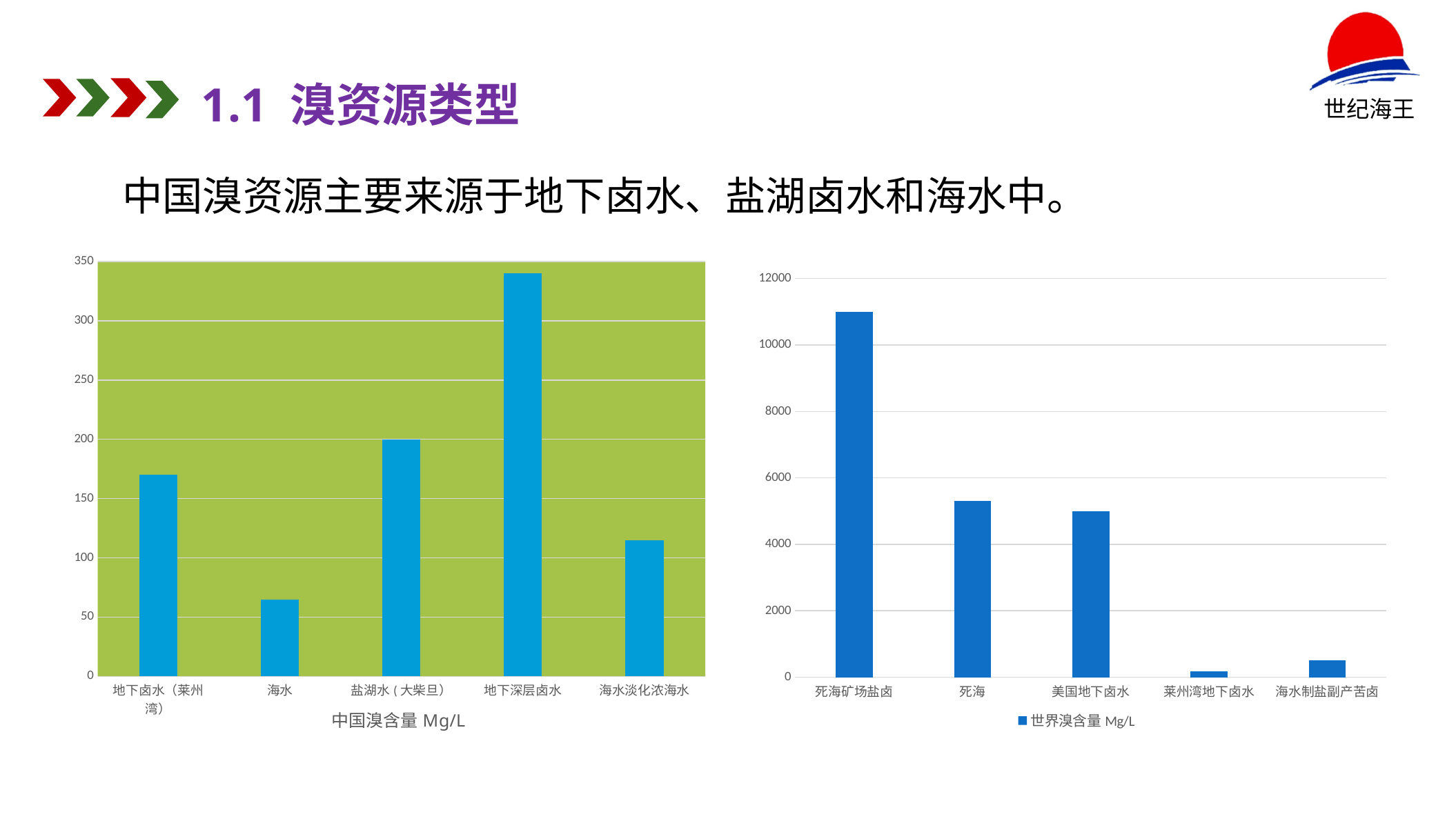
What is the legend entry shown below the right chart? 世界溴含量 Mg/L In the left chart (中国溴含量 Mg/L), which is larger, the value for 海水淡化浓海水 or the value for 盐湖水(大柴旦)? 盐湖水(大柴旦) In the left chart (中国溴含量 Mg/L), is the value for 海水 greater or less than 100? less How many categories are shown in the left chart (中国溴含量 Mg/L)? 5 In the right chart (世界溴含量 Mg/L), which category has the highest value? 死海矿场盐卤 How many series does the legend of the right chart (世界溴含量 Mg/L) list? 1 In the right chart (世界溴含量 Mg/L), is the value for 死海矿场盐卤 greater or less than 10000? greater In the left chart (中国溴含量 Mg/L), which category has the highest value? 地下深层卤水 In the left chart (中国溴含量 Mg/L), is the value for 地下卤水（莱州湾） greater or less than 150? greater What kind of chart is the left chart titled 中国溴含量 Mg/L? bar chart In the right chart (世界溴含量 Mg/L), which category has the lowest value? 莱州湾地下卤水 In the left chart (中国溴含量 Mg/L), which category has the lowest value? 海水